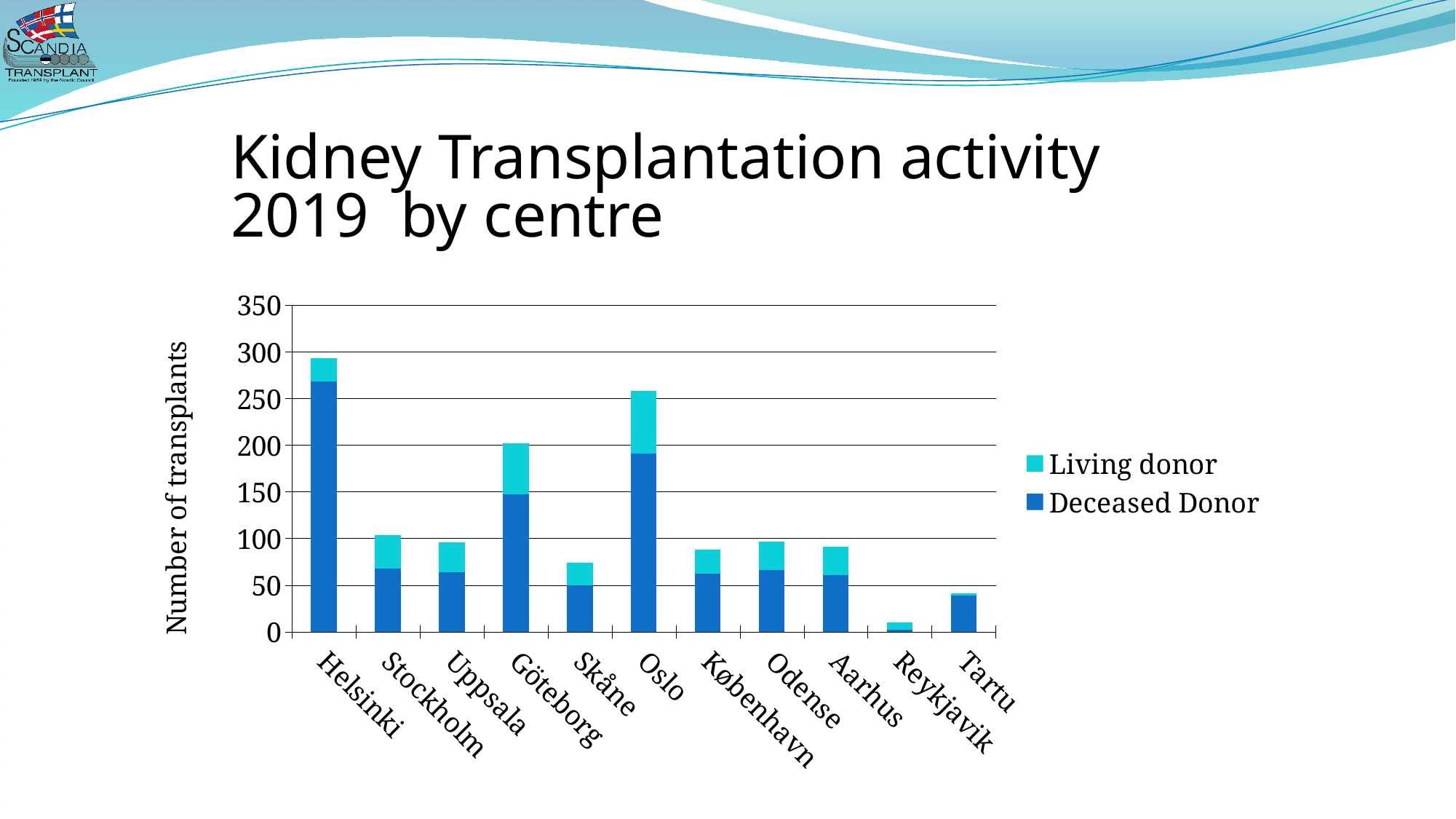
What kind of chart is shown on the slide? Stacked bar chart How many series does the chart's legend list? 2 Is the total number of transplants for Helsinki greater or less than 250? greater What is the title of the chart's y axis? Number of transplants Which centre has the highest total number of transplants? Helsinki Which centre has a larger total number of transplants, Oslo or Göteborg? Oslo Is the total number of transplants for Tartu greater or less than 50? less How many centres are shown on the x axis of the chart? 11 Is the Deceased Donor value for Oslo greater or less than 150? greater Which centre has a larger Deceased Donor value, Helsinki or Oslo? Helsinki Which centre has the lowest total number of transplants? Reykjavik